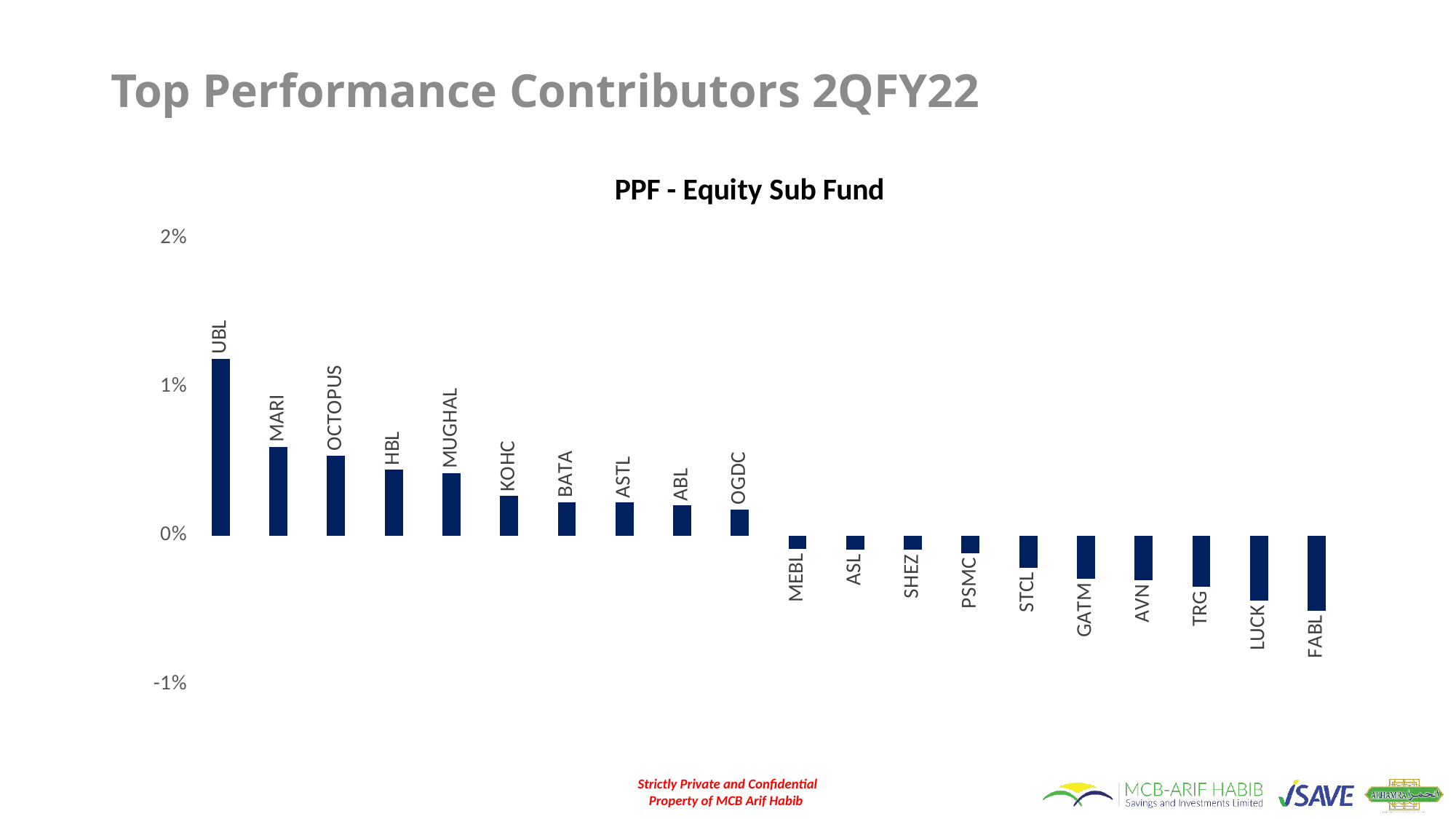
Which has the larger value, UBL or MARI? UBL Is the value for FABL greater or less than 0%? less Which category has the highest value in the chart? UBL Is the value for UBL greater or less than 1%? greater Is the value for MARI greater or less than 1%? less How many categories in the chart have negative values? 10 Which has the larger value, KOHC or OGDC? KOHC Do the values generally rise or fall moving from left to right along the x axis? fall What is the title of the chart? PPF - Equity Sub Fund What kind of chart is shown on the slide? Bar chart How many categories (stocks) are plotted in the chart? 20 Which category has the lowest value in the chart? FABL